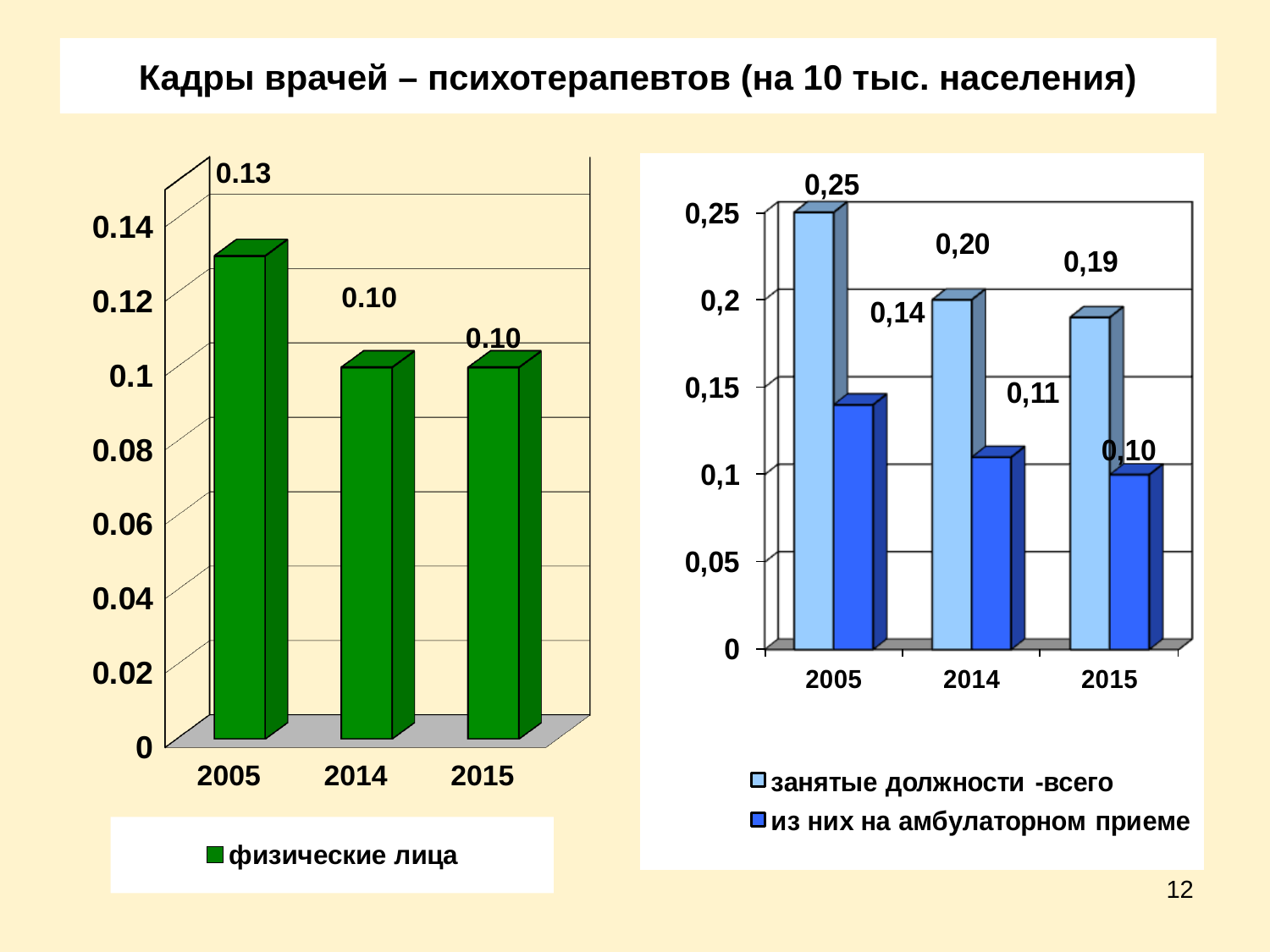
In the left chart, what is the value for физические лица in 2005? 0.13 In the left chart, how many years are shown on the x axis? 3 In the left chart, what is the difference between the 2005 and 2015 values for физические лица? 0.03 In the right chart, which is larger in 2014: занятые должности -всего or из них на амбулаторном приеме? занятые должности -всего In the right chart, what is the value for из них на амбулаторном приеме in 2014? 0,11 In the right chart, what is the value for занятые должности -всего in 2015? 0,19 In the right chart, what is the value for занятые должности -всего in 2005? 0,25 In the right chart, what is the difference between занятые должности -всего and из них на амбулаторном приеме in 2005? 0,11 In the right chart, do the values for занятые должности -всего rise or fall from 2005 to 2015? fall In the left chart, what is the value for физические лица in 2014? 0.10 In the left chart, which year has the highest value for физические лица? 2005 In the right chart, how many series does the legend list? 2